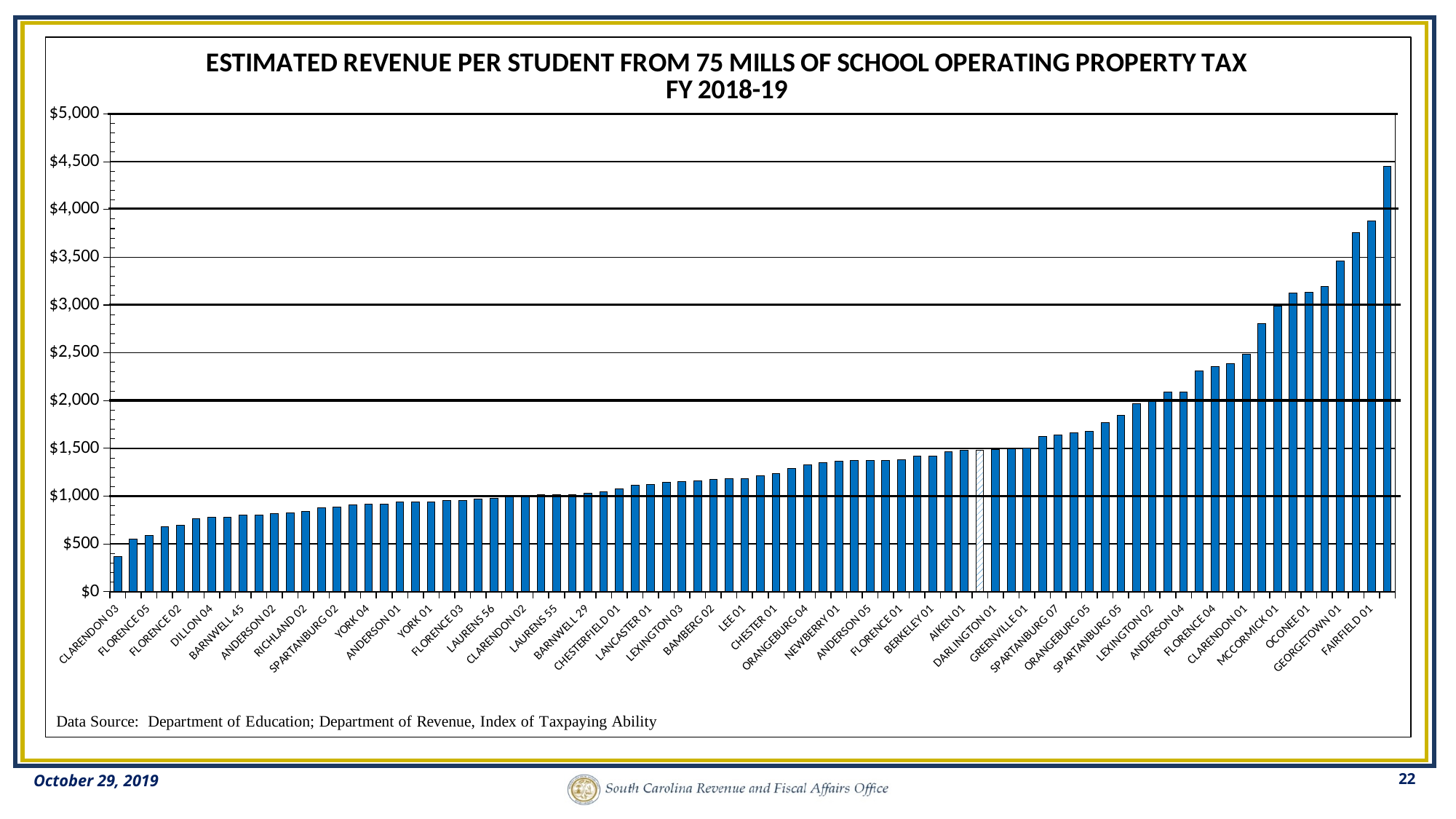
Which is larger, the value for MCCORMICK 01 or the value for LEE 01? MCCORMICK 01 Is the value for FAIRFIELD 01 greater or less than $4,000? less What fiscal year does the chart title refer to? FY 2018-19 What is the highest value shown on the y axis? $5,000 Do the values rise or fall moving from left to right along the x axis? rise Which district has the lowest estimated revenue per student? CLARENDON 03 Is the value for DILLON 04 greater or less than $1,000? less Is the value for FLORENCE 04 greater or less than $2,000? greater What kind of chart is shown on the slide? bar chart